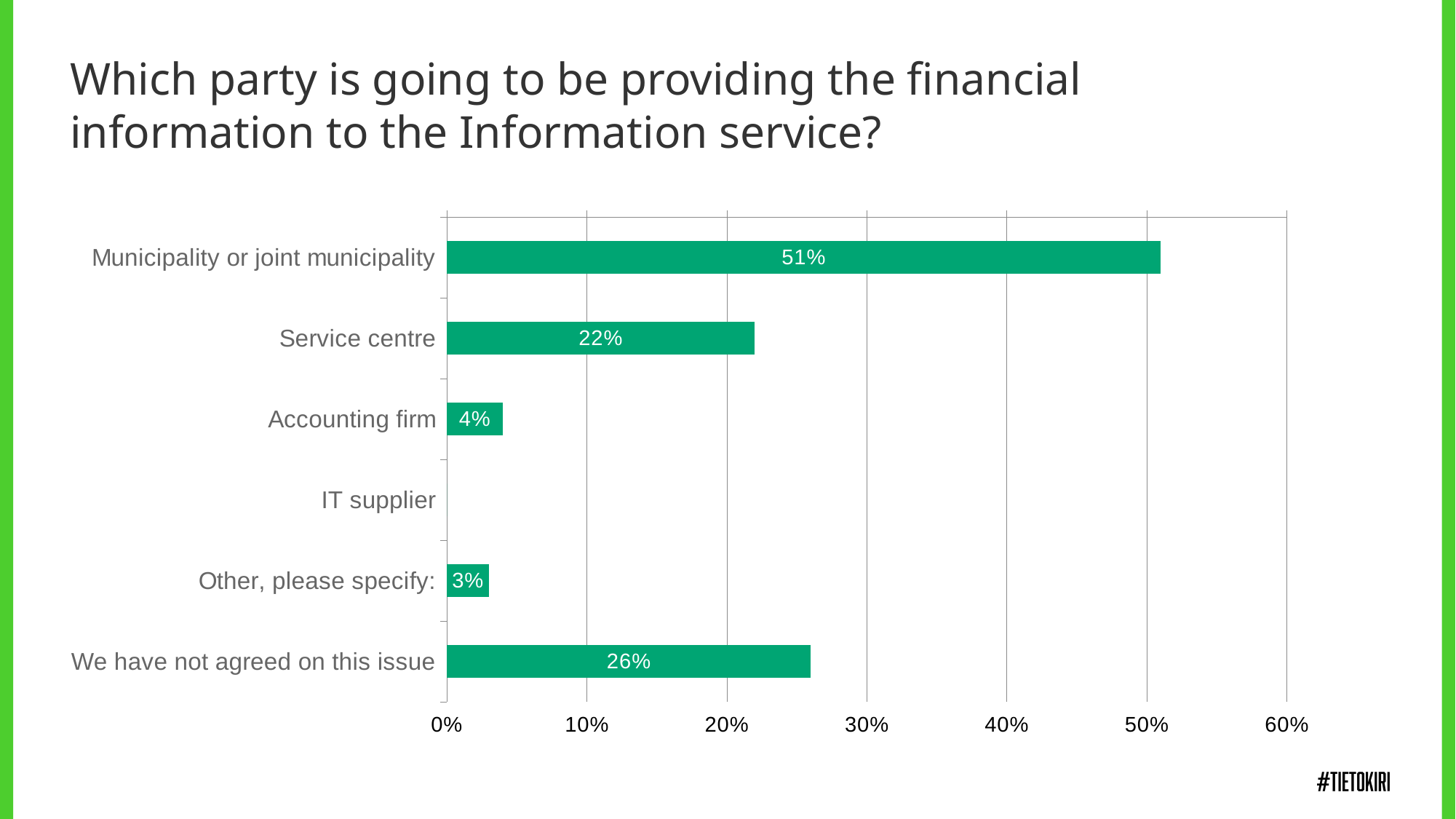
Is the value for Municipality or joint municipality greater or less than 50%? greater Which category has the highest value? Municipality or joint municipality What kind of chart is shown on the slide? Bar chart How many categories are listed on the chart? 6 What percentage is shown for We have not agreed on this issue? 26% What is the value for Service centre? 22% Which labelled category has the lowest non-zero value? Other, please specify: What is the highest value shown on the x axis? 60% What is the value for Accounting firm? 4% Which is larger, the value for Service centre or the value for We have not agreed on this issue? We have not agreed on this issue What is the difference between the values for Municipality or joint municipality and Service centre? 29% What percentage is shown for Municipality or joint municipality? 51%